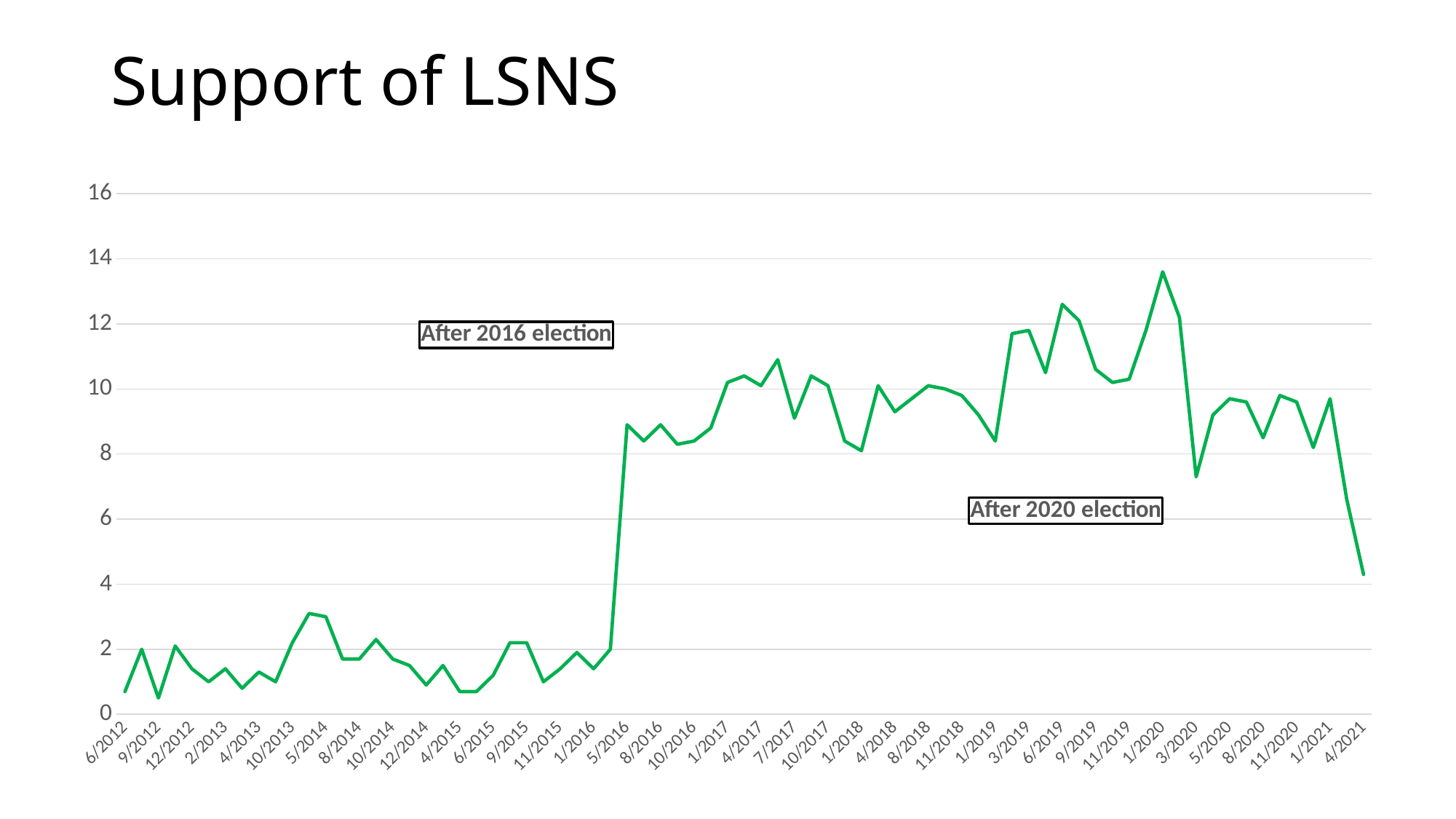
Is the value for 5/2016 greater or less than 8? greater What colour is the line in the chart? green What is the title of the chart? Support of LSNS Which has the larger value, 1/2020 or 4/2021? 1/2020 Is the value for 5/2014 greater or less than 4? less Does the line rise or fall between 1/2021 and 4/2021? fall Is the value for 1/2020 greater or less than 12? greater At which x-axis date does the line reach its highest value? 1/2020 Which has the larger value, 1/2016 or 5/2016? 5/2016 What kind of chart is shown on the slide? line chart